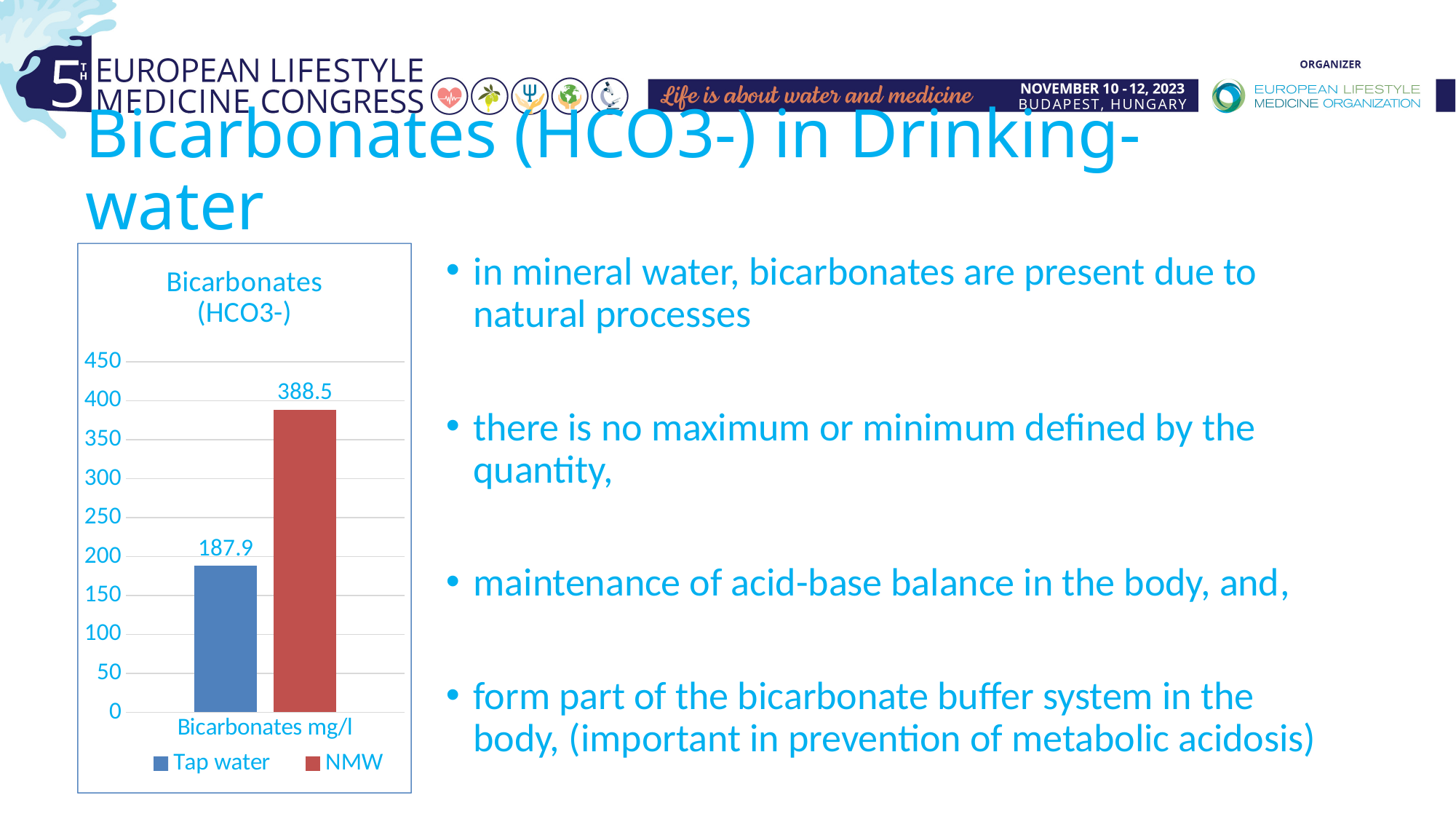
Which series has the lower bicarbonate value in the chart? Tap water How many series does the legend of the chart list? 2 Which series has the higher bicarbonate value, Tap water or NMW? NMW What is the difference between the NMW and Tap water bicarbonate values? 200.6 What kind of chart is shown on the slide? bar chart Is the value for NMW greater or less than 350? greater What is the value for Tap water in the Bicarbonates (HCO3-) chart? 187.9 What is the value for NMW in the Bicarbonates (HCO3-) chart? 388.5 What is the title of the chart on the slide? Bicarbonates (HCO3-) Is the value for Tap water greater or less than 200? less What is the x-axis category label in the chart? Bicarbonates mg/l What is the highest value shown on the y-axis of the chart? 450